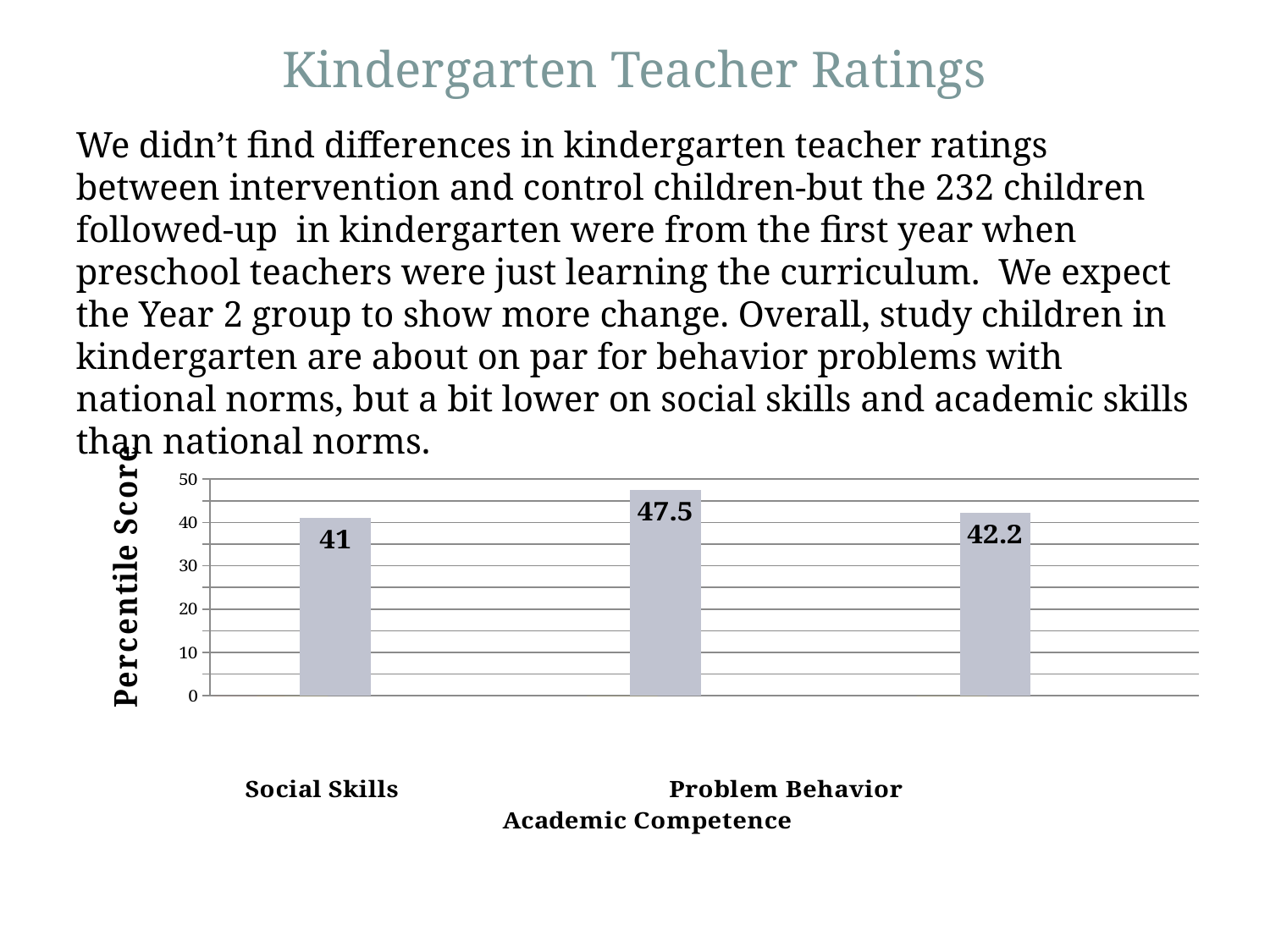
Is the value for Social Skills greater or less than 50? less Which category has the lowest percentile score? Social Skills What is the value of the middle bar in the chart? 47.5 What type of chart is shown on the slide? bar chart How many bars are plotted in the chart? 3 Which is larger, the value of the middle bar or the value of the rightmost bar? the middle bar What is the percentile score for Social Skills? 41 What is the maximum value shown on the vertical axis? 50 What is the label on the vertical axis of the chart? Percentile Score What is the value of the rightmost bar in the chart? 42.2 What is the difference between the highest bar (47.5) and the Social Skills bar (41)? 6.5